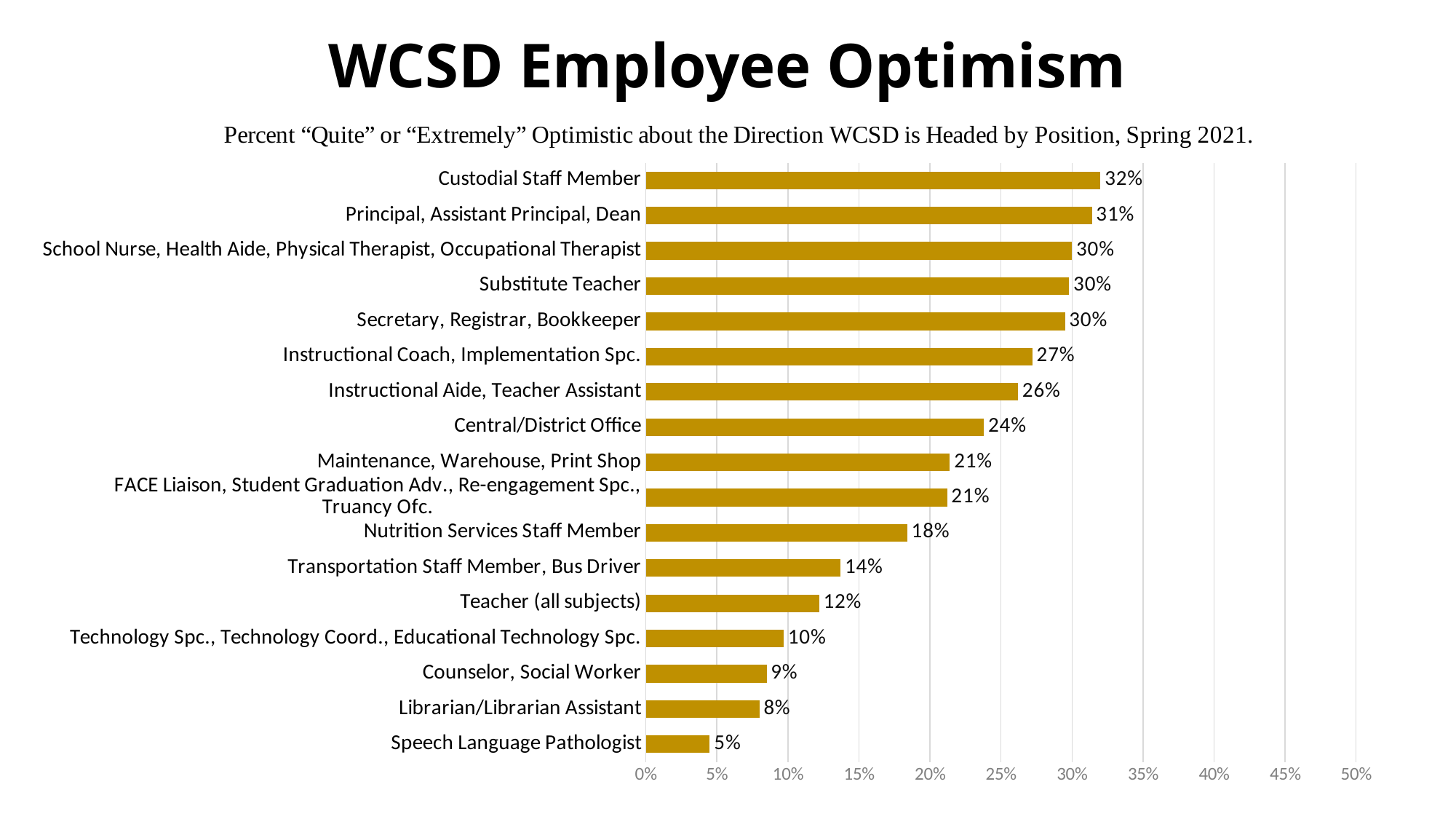
Which position has the lowest percent optimistic? Speech Language Pathologist Which position has the highest percent optimistic? Custodial Staff Member What kind of chart is shown on the slide? Bar chart Is the value for Librarian/Librarian Assistant greater or less than 10%? less What percent of Custodial Staff Members are quite or extremely optimistic about the direction WCSD is headed? 32% What is the value shown for Teacher (all subjects)? 12% What is the value shown for Counselor, Social Worker? 9% What is the title of the chart on the slide? WCSD Employee Optimism Which has a higher value: Instructional Aide, Teacher Assistant or Transportation Staff Member, Bus Driver? Instructional Aide, Teacher Assistant How many positions are shown in the chart? 17 What is the difference in percentage points between Custodial Staff Member and Speech Language Pathologist? 27 What is the difference in percentage points between Central/District Office and Nutrition Services Staff Member? 6